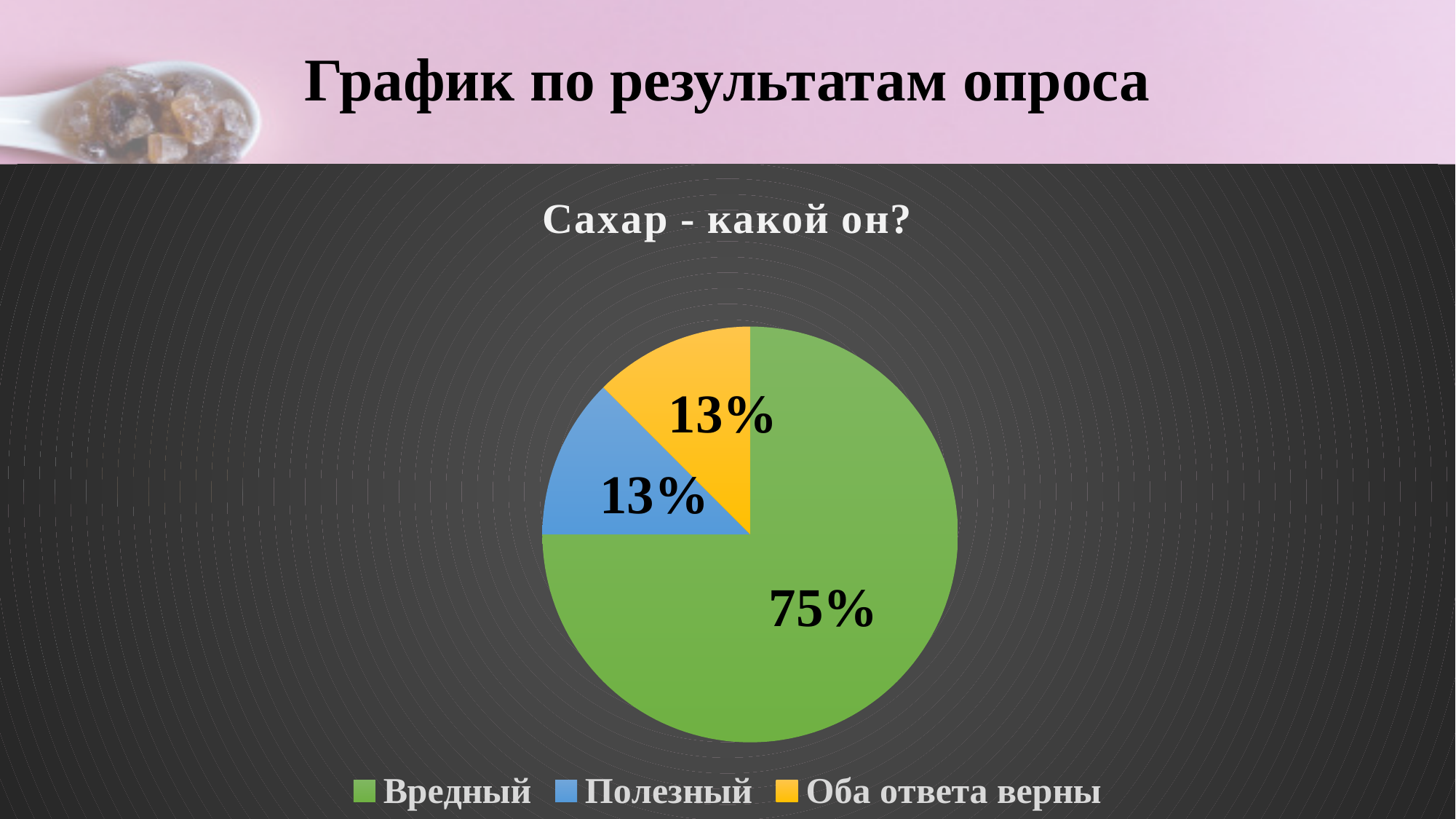
How many entries does the legend list? 3 How many slices does the pie chart have? 3 What colour is the slice for Полезный? Blue What share of the pie does Оба ответа верны have? 13% Which category has the largest slice of the pie? Вредный Which is larger, the slice for Вредный or the slice for Оба ответа верны? Вредный What share of the pie does Полезный have? 13% What share of the pie does Вредный have? 75% What is the title of the chart? Сахар - какой он? What kind of chart is shown on the slide? Pie chart What is the difference between the share for Вредный and the share for Полезный? 62%